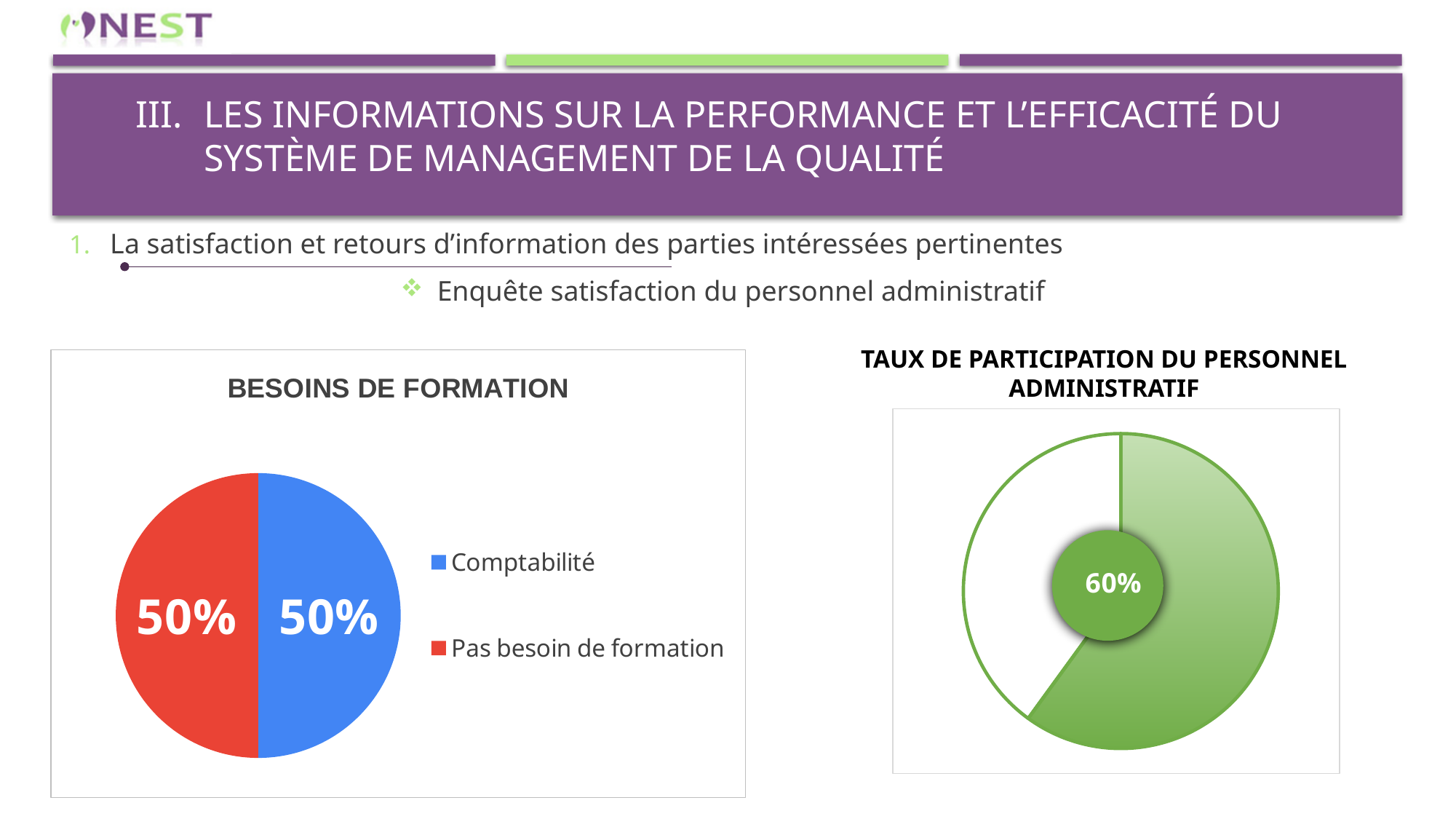
In the 'BESOINS DE FORMATION' chart, which colour represents Comptabilité? Blue What value is shown in the centre of the 'TAUX DE PARTICIPATION DU PERSONNEL ADMINISTRATIF' chart? 60% Which is larger: the participation rate in the 'TAUX DE PARTICIPATION DU PERSONNEL ADMINISTRATIF' chart or the Comptabilité share in the 'BESOINS DE FORMATION' chart? The participation rate (60%) In the 'BESOINS DE FORMATION' chart, what share is labelled for Comptabilité? 50% What kind of chart is 'TAUX DE PARTICIPATION DU PERSONNEL ADMINISTRATIF'? Pie chart How many entries does the legend of the 'BESOINS DE FORMATION' chart list? 2 Is the participation rate shown in the 'TAUX DE PARTICIPATION DU PERSONNEL ADMINISTRATIF' chart greater or less than 50%? greater How many slices does the 'BESOINS DE FORMATION' pie chart have? 2 In the 'BESOINS DE FORMATION' chart, which colour represents Pas besoin de formation? Red In the 'BESOINS DE FORMATION' chart, what share is labelled for Pas besoin de formation? 50% In the 'BESOINS DE FORMATION' chart, what is the difference between the Comptabilité share and the Pas besoin de formation share? 0% What kind of chart is 'BESOINS DE FORMATION'? Pie chart